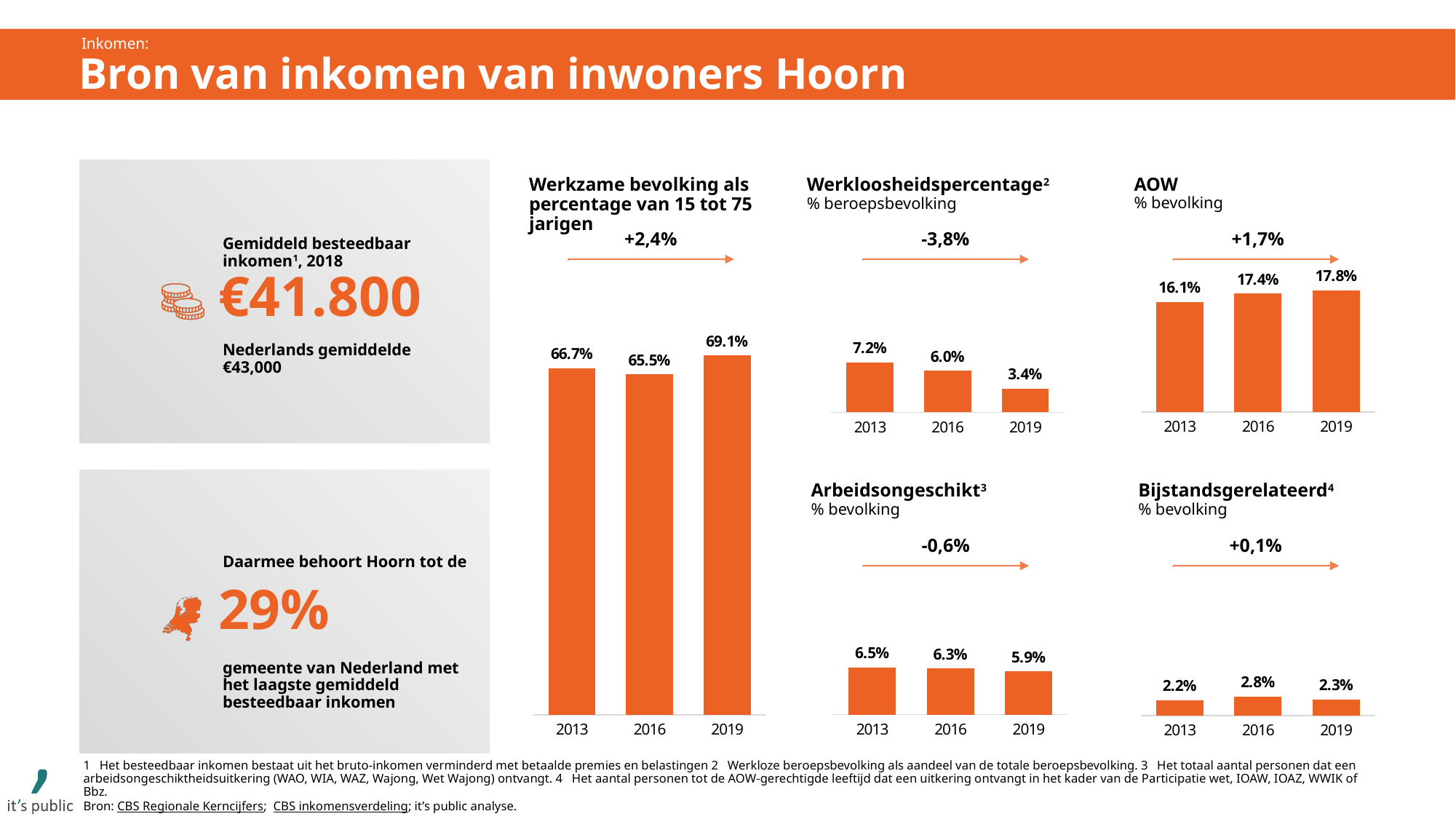
What kind of chart is the Arbeidsongeschikt chart? bar chart In the Bijstandsgerelateerd chart, which year has the lowest value? 2013 In the Werkloosheidspercentage chart, what is the difference between the 2013 and 2019 values? 3.8% In the AOW chart, do the values rise or fall from 2013 to 2019? rise In the AOW chart, what is the value for 2013? 16.1% In the Werkzame bevolking chart, what is the difference between the 2019 and 2013 values? 2.4% In the Arbeidsongeschikt chart, which is larger, the value for 2013 or the value for 2019? 2013 In the Werkloosheidspercentage chart, what is the value for 2019? 3.4% In the Werkloosheidspercentage chart, do the values rise or fall from 2013 to 2019? fall How many years are shown in the AOW chart? 3 In the Bijstandsgerelateerd chart, which is larger, the value for 2016 or the value for 2019? 2016 In the Werkzame bevolking chart, which year has the highest value? 2019